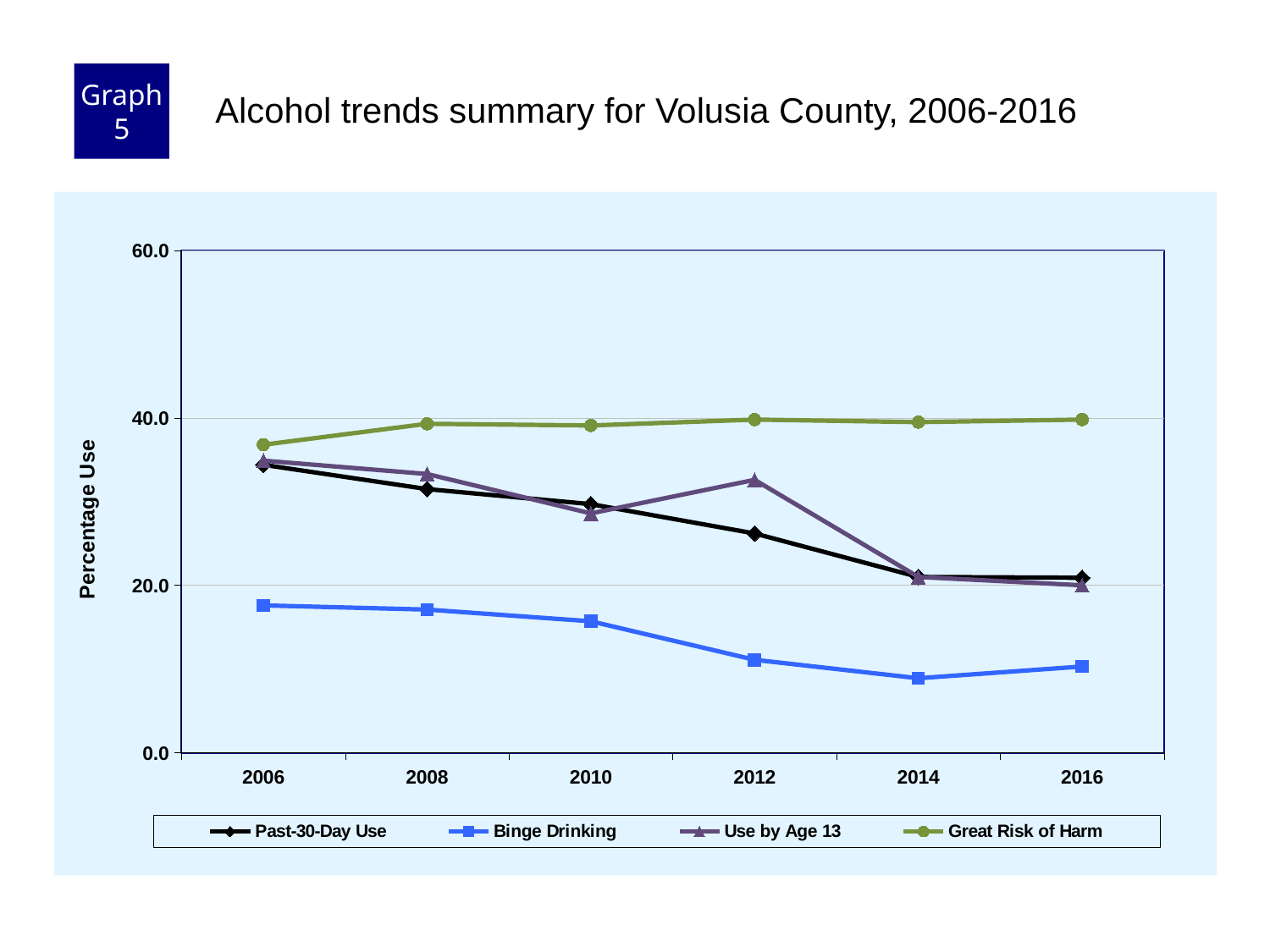
Does the Past-30-Day Use series rise or fall from 2006 to 2016? fall How many series does the legend list? 4 How many years are plotted along the x axis? 6 In 2012, which is larger: Great Risk of Harm or Binge Drinking? Great Risk of Harm Which series has the lowest value in 2010? Binge Drinking What is the title of the chart? Alcohol trends summary for Volusia County, 2006-2016 What kind of chart is shown on the slide? line chart Is the value for Binge Drinking in 2014 greater or less than 20.0? less Which series has the highest value in 2016? Great Risk of Harm Is the value for Great Risk of Harm in 2006 greater or less than 40.0? less Is the value for Use by Age 13 in 2012 greater or less than 20.0? greater What is the label on the y axis? Percentage Use